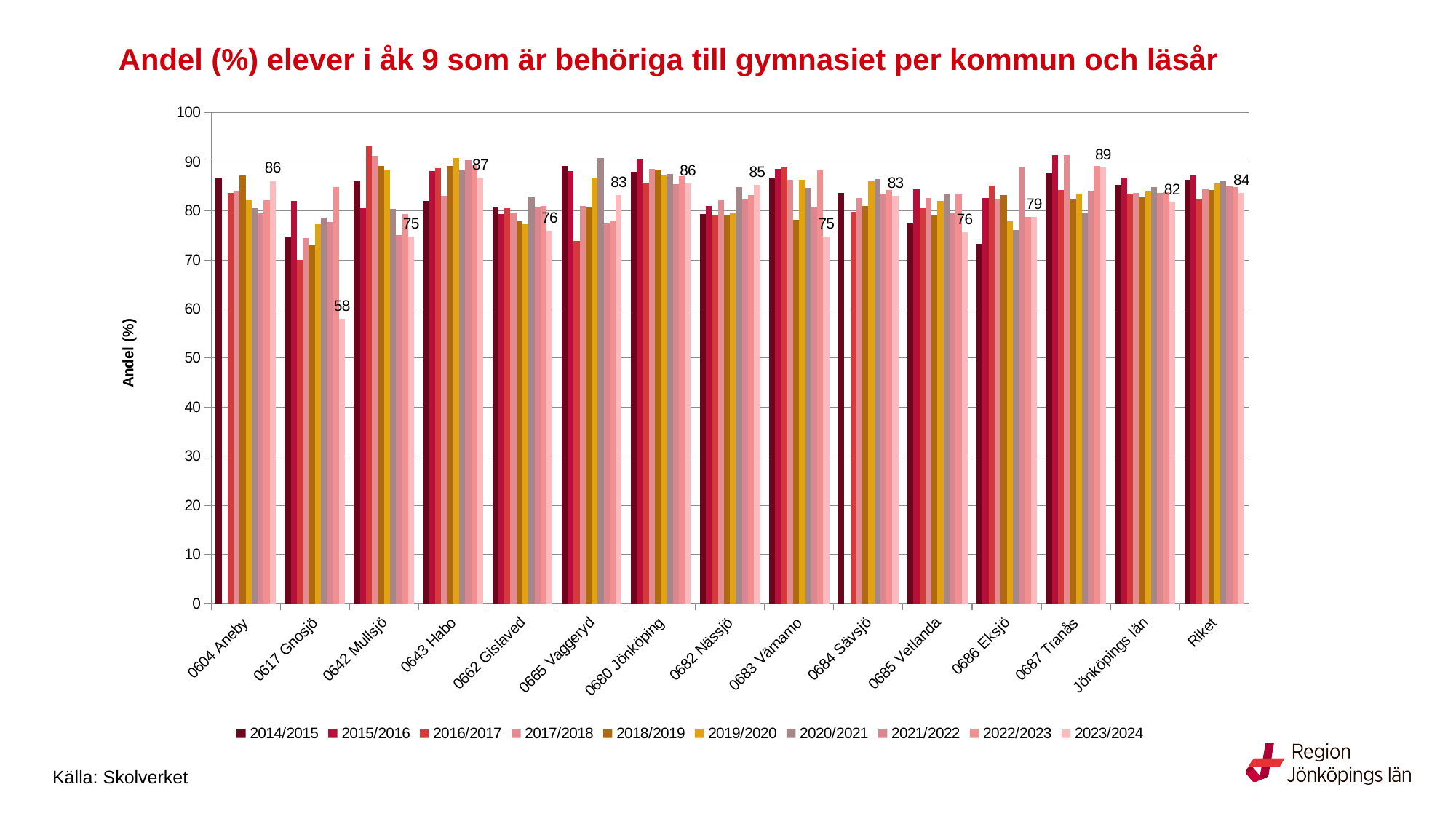
Is the 2014/2015 value for 0686 Eksjö greater or less than 80? less What is the difference between the 2023/2024 values for 0687 Tranås and 0617 Gnosjö? 31 What is the label of the y axis? Andel (%) What kind of chart is shown on the slide? bar chart How many categories are shown on the x axis? 15 Which category has the highest 2023/2024 value? 0687 Tranås What is the value for 0617 Gnosjö in the 2023/2024 series? 58 What is the value for 0687 Tranås in the 2023/2024 series? 89 What is the value for Riket in the 2023/2024 series? 84 Which has the larger 2023/2024 value, 0643 Habo or 0642 Mullsjö? 0643 Habo Which municipality has the lowest 2023/2024 value? 0617 Gnosjö How many series does the legend list? 10